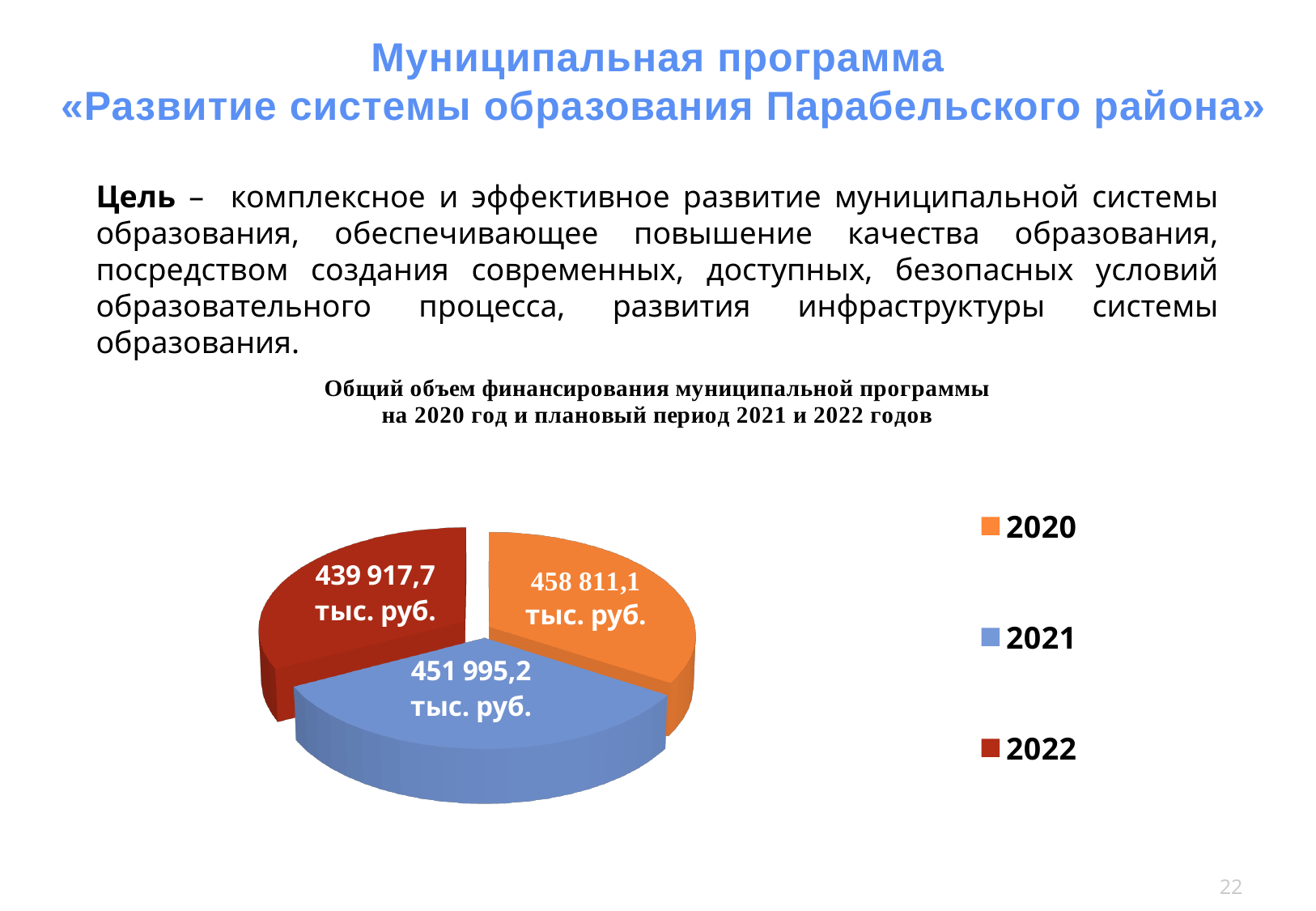
What is the funding amount for 2022 on the pie chart? 439 917,7 тыс. руб. What type of chart is shown on the slide? Pie chart Which year has the largest funding amount on the pie chart? 2020 Which colour represents 2022 in the pie chart? Red What is the difference between the funding amounts for 2020 and 2022? 18 893,4 тыс. руб. Which is larger, the funding amount for 2020 or for 2021? 2020 What is the difference between the funding amounts for 2021 and 2022? 12 077,5 тыс. руб. How many slices does the pie chart have? 3 What is the funding amount for 2020 on the pie chart? 458 811,1 тыс. руб. Which year has the smallest funding amount on the pie chart? 2022 What is the funding amount for 2021 on the pie chart? 451 995,2 тыс. руб. How many entries does the chart legend list? 3